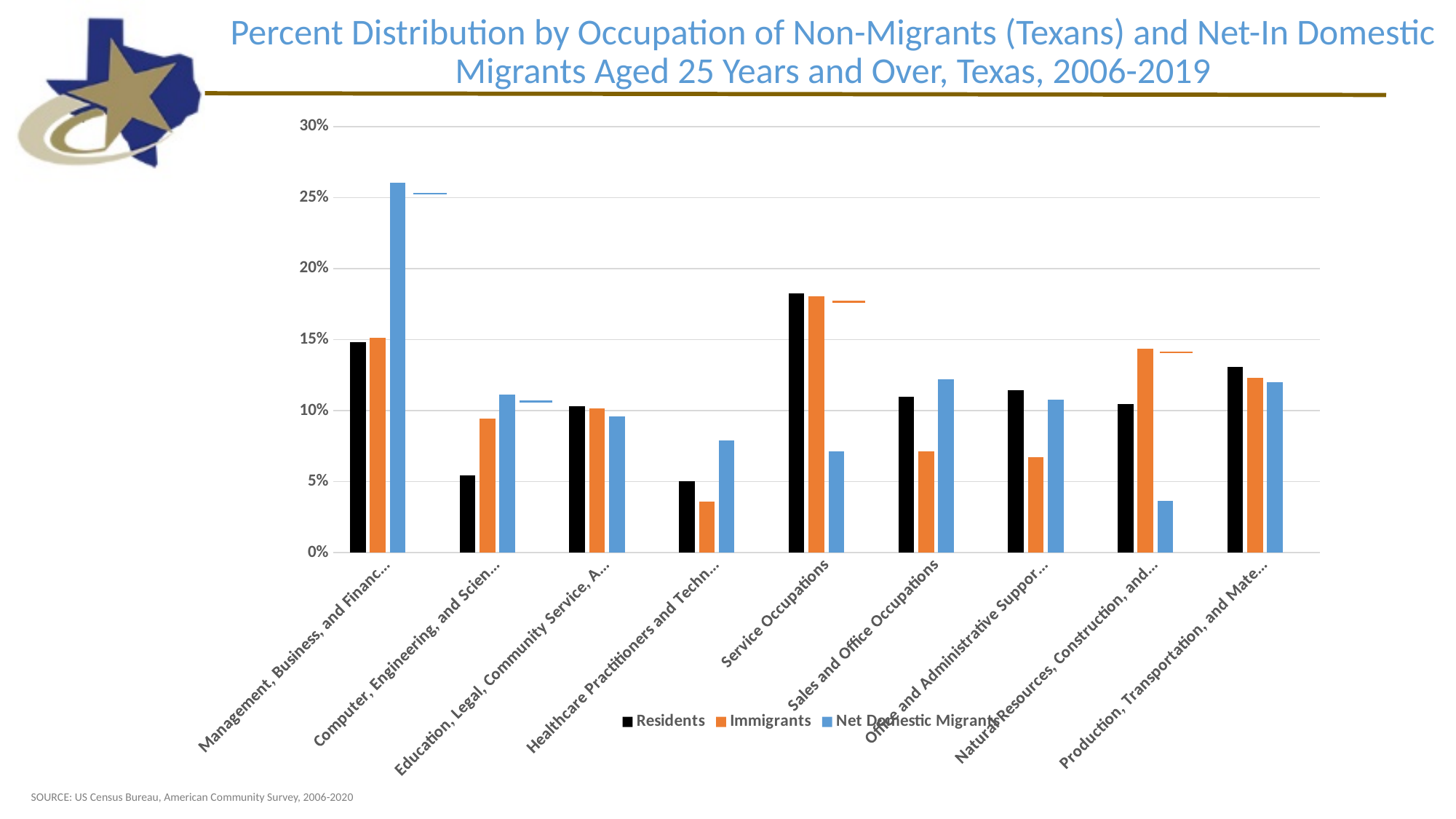
For Natural Resources, Construction, and Maintenance, which is larger: the Immigrants value or the Net Domestic Migrants value? Immigrants Which occupation category has the highest value for Residents? Service Occupations What kind of chart is shown on the slide? bar chart Is the Net Domestic Migrants value for Sales and Office Occupations greater or less than 10%? greater Which colour represents the Immigrants series in the chart? orange How many series does the legend list? 3 Which occupation category has the highest value for Net Domestic Migrants? Management, Business, and Financial Which occupation category has the lowest value for Immigrants? Healthcare Practitioners and Technical Is the Net Domestic Migrants value for Management, Business, and Financial greater or less than 25%? greater For Service Occupations, which is larger: the Residents value or the Net Domestic Migrants value? Residents How many occupation categories are shown on the x axis? 9 Is the Immigrants value for Healthcare Practitioners and Technical greater or less than 5%? less